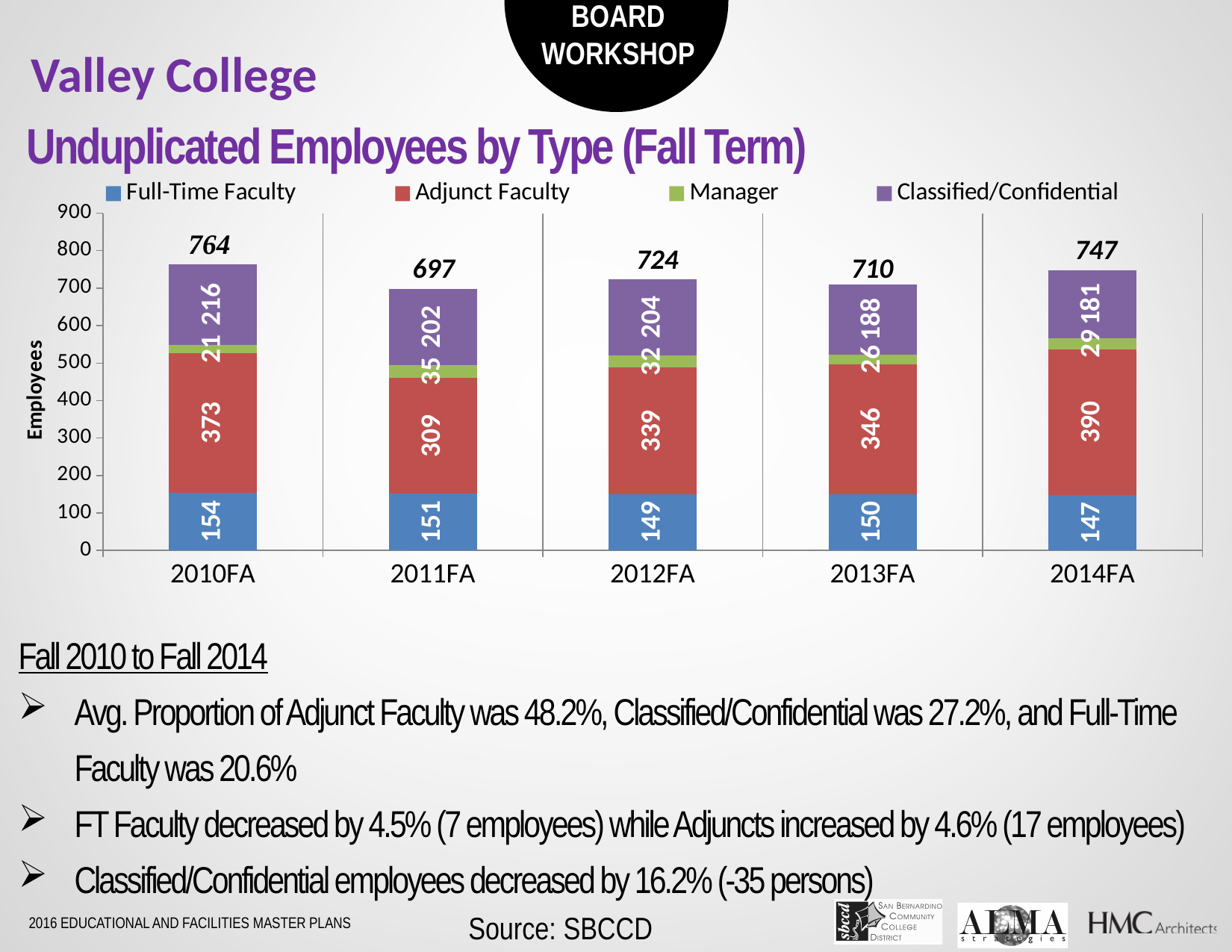
Which series is shown in green in the legend? Manager How many fall terms are shown on the x axis? 5 Which fall term has the lowest total number of employees? 2011FA Which is larger, the number of Adjunct Faculty in 2012FA or in 2013FA? 2013FA What is the number of Managers in 2011FA? 35 What is the number of Adjunct Faculty in 2014FA? 390 What is the total number of employees in 2013FA? 710 What is the difference in Classified/Confidential employees between 2010FA and 2014FA? 35 What kind of chart is shown on the slide? Stacked bar chart What is the number of Full-Time Faculty in 2010FA? 154 Which fall term has the highest total number of employees? 2010FA How many series does the legend list? 4